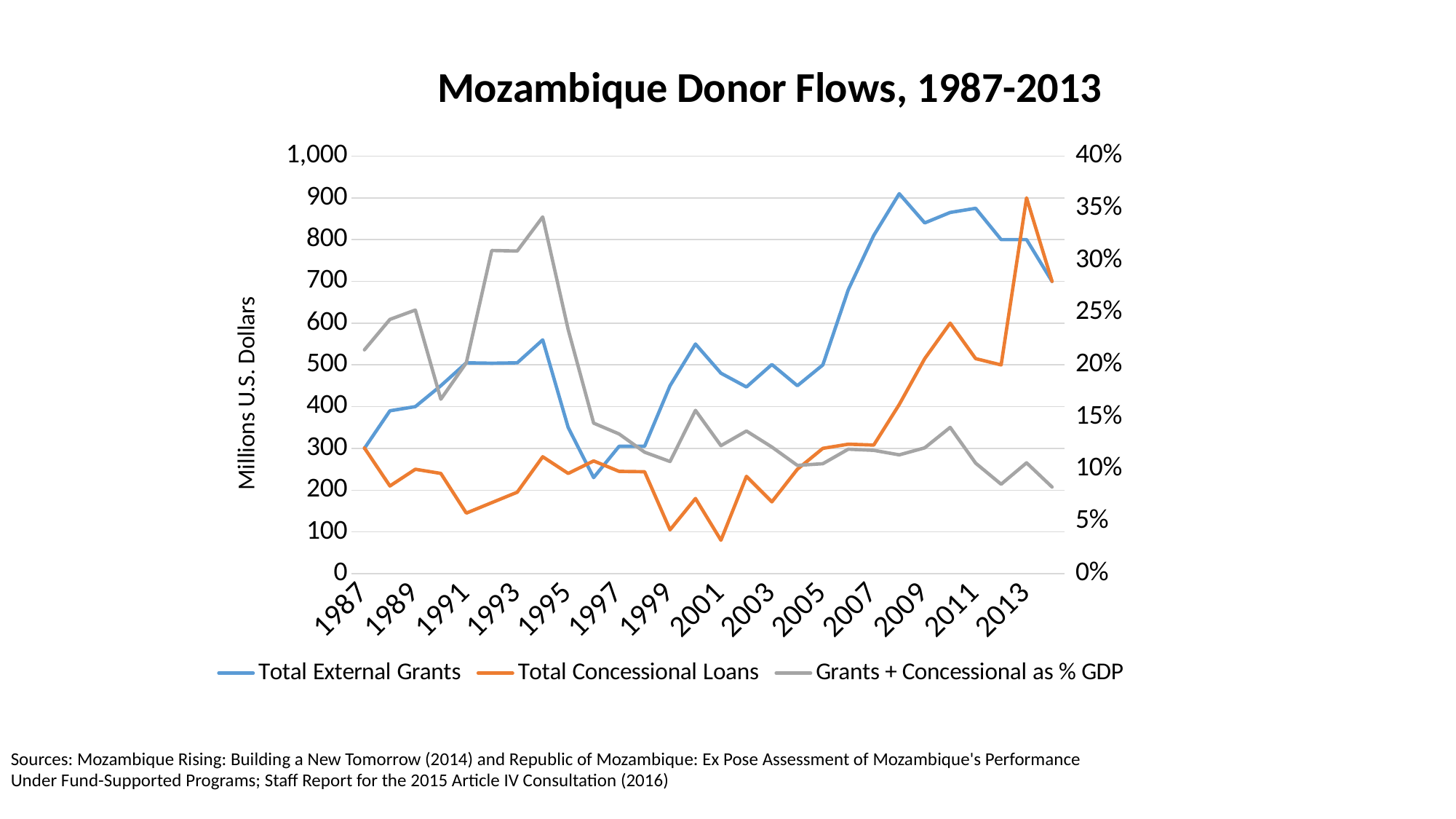
In which year does Grants + Concessional as % GDP reach its highest value? 1994 Is the value for Total External Grants in 2008 greater or less than 800? greater What kind of chart is shown on the slide? line chart Is the value for Total Concessional Loans in 2001 greater or less than 100? less In 2000, which is larger, Total External Grants or Total Concessional Loans? Total External Grants What is the title of the chart? Mozambique Donor Flows, 1987-2013 In which year does Total External Grants reach its highest value? 2008 In which year does Total Concessional Loans reach its lowest value? 2001 What is the label on the left vertical axis? Millions U.S. Dollars In which year does Total Concessional Loans reach its highest value? 2013 How many series does the legend list? 3